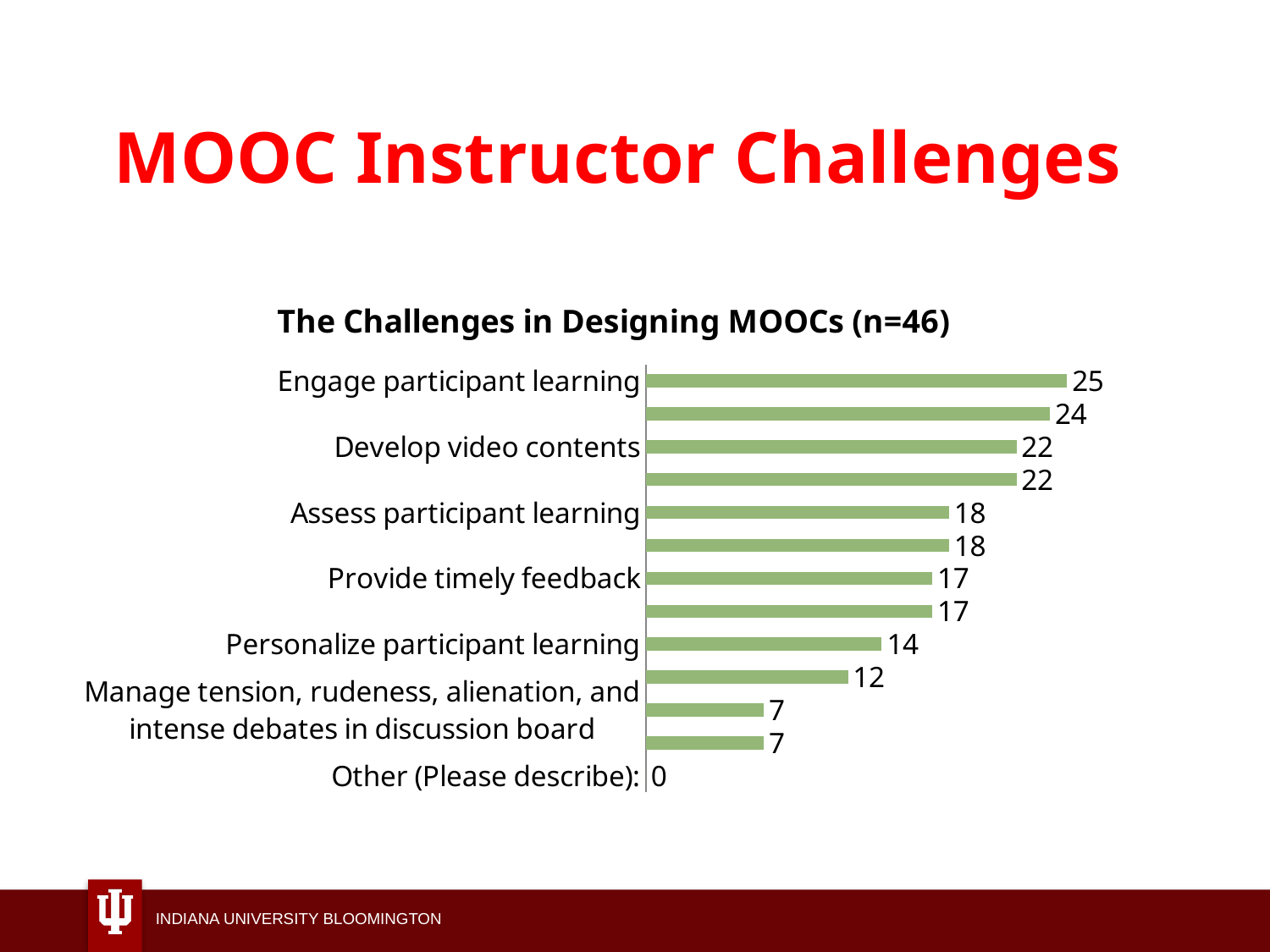
What is the title of the chart? The Challenges in Designing MOOCs (n=46) What is the value for Other (Please describe):? 0 What is the value for Provide timely feedback? 17 Which is larger, the value for Assess participant learning or the value for Personalize participant learning? Assess participant learning What is the value for Develop video contents? 22 What kind of chart is shown on the slide? Bar chart What is the value for Personalize participant learning? 14 Which labeled challenge has the lowest value? Other (Please describe): Which labeled challenge has the highest value? Engage participant learning What is the value for Assess participant learning? 18 What is the difference between the values for Engage participant learning and Develop video contents? 3 What is the value for Engage participant learning? 25